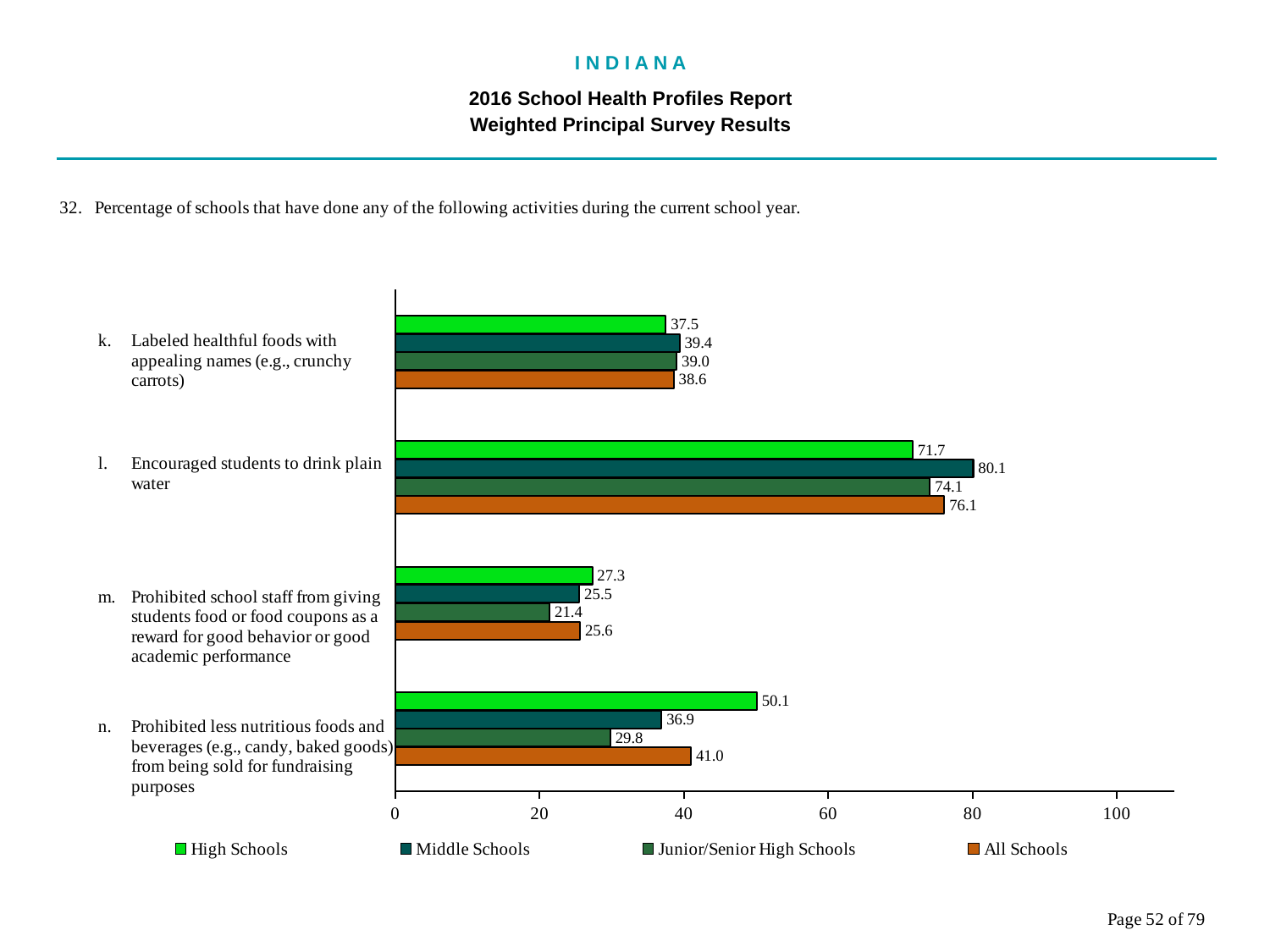
Is the All Schools value for 'Encouraged students to drink plain water' greater or less than 60? greater What is the value for High Schools for 'Prohibited less nutritious foods and beverages from being sold for fundraising purposes'? 50.1 What is the All Schools value for 'Labeled healthful foods with appealing names'? 38.6 What kind of chart is shown on the slide? bar chart What is the value for Middle Schools for 'Encouraged students to drink plain water'? 80.1 How many series does the legend list? 4 Which legend entry is shown in orange? All Schools How many activities (categories) are shown on the chart? 4 What is the difference between the High Schools and Junior/Senior High Schools values for 'Prohibited less nutritious foods and beverages from being sold for fundraising purposes'? 20.3 Which school type has the lowest value for 'Prohibited school staff from giving students food or food coupons as a reward'? Junior/Senior High Schools Which activity has the highest All Schools value? Encouraged students to drink plain water Which is larger for 'Encouraged students to drink plain water': the High Schools value or the Middle Schools value? Middle Schools